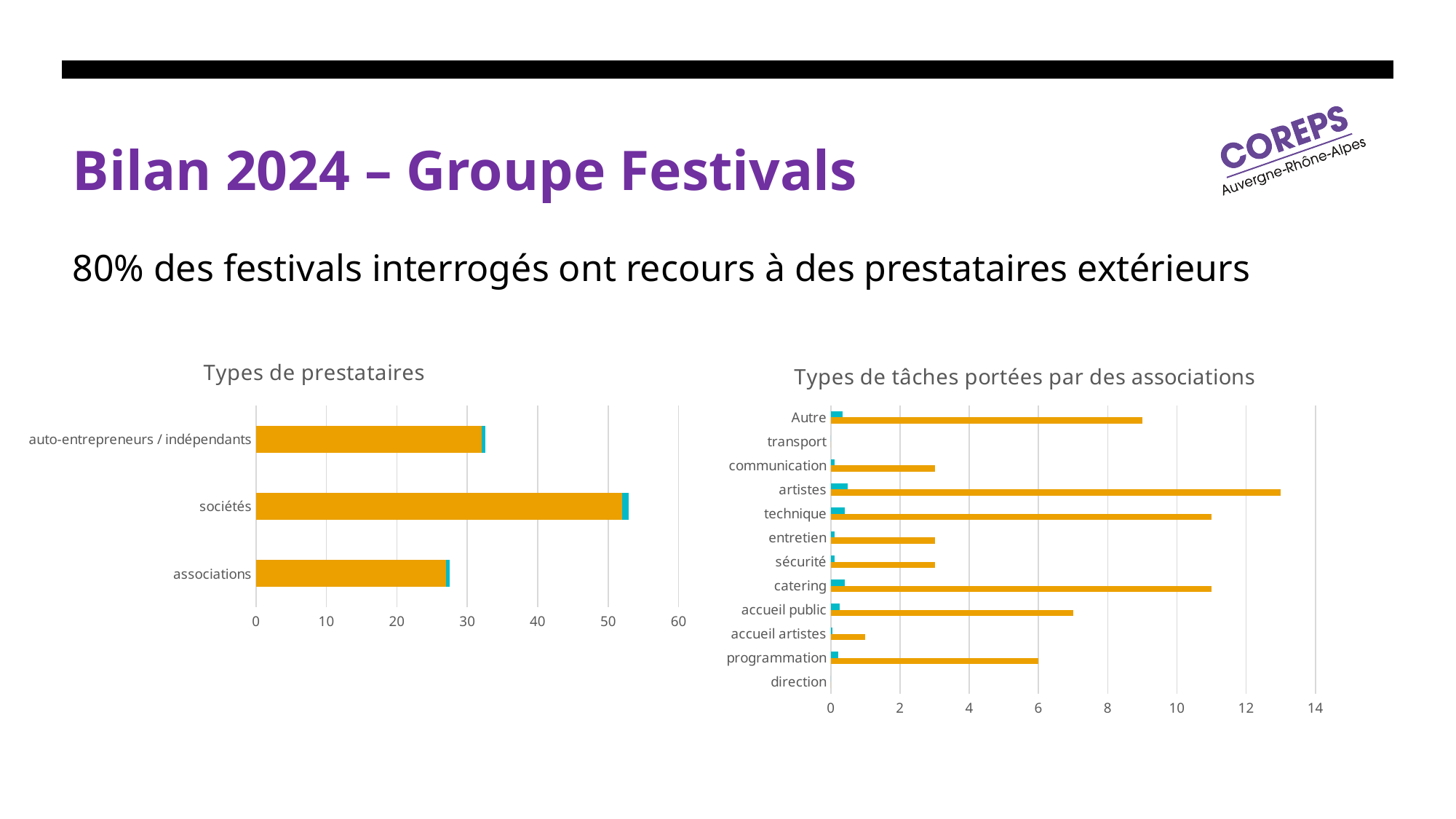
In the 'Types de prestataires' chart, is the value for sociétés greater or less than 50? greater In the 'Types de tâches portées par des associations' chart, is the value for communication greater or less than 4? less What kind of chart is the 'Types de prestataires' chart? bar chart How many categories are shown in the 'Types de prestataires' chart? 3 In the 'Types de tâches portées par des associations' chart, which is larger: accueil public or programmation? accueil public In the 'Types de prestataires' chart, which category has the highest value? sociétés In the 'Types de tâches portées par des associations' chart, is the value for artistes greater or less than 12? greater What is the title of the chart on the right of the slide? Types de tâches portées par des associations In the 'Types de prestataires' chart, which category has the lowest value? associations In the 'Types de tâches portées par des associations' chart, which category has the highest value? artistes How many categories are listed in the 'Types de tâches portées par des associations' chart? 12